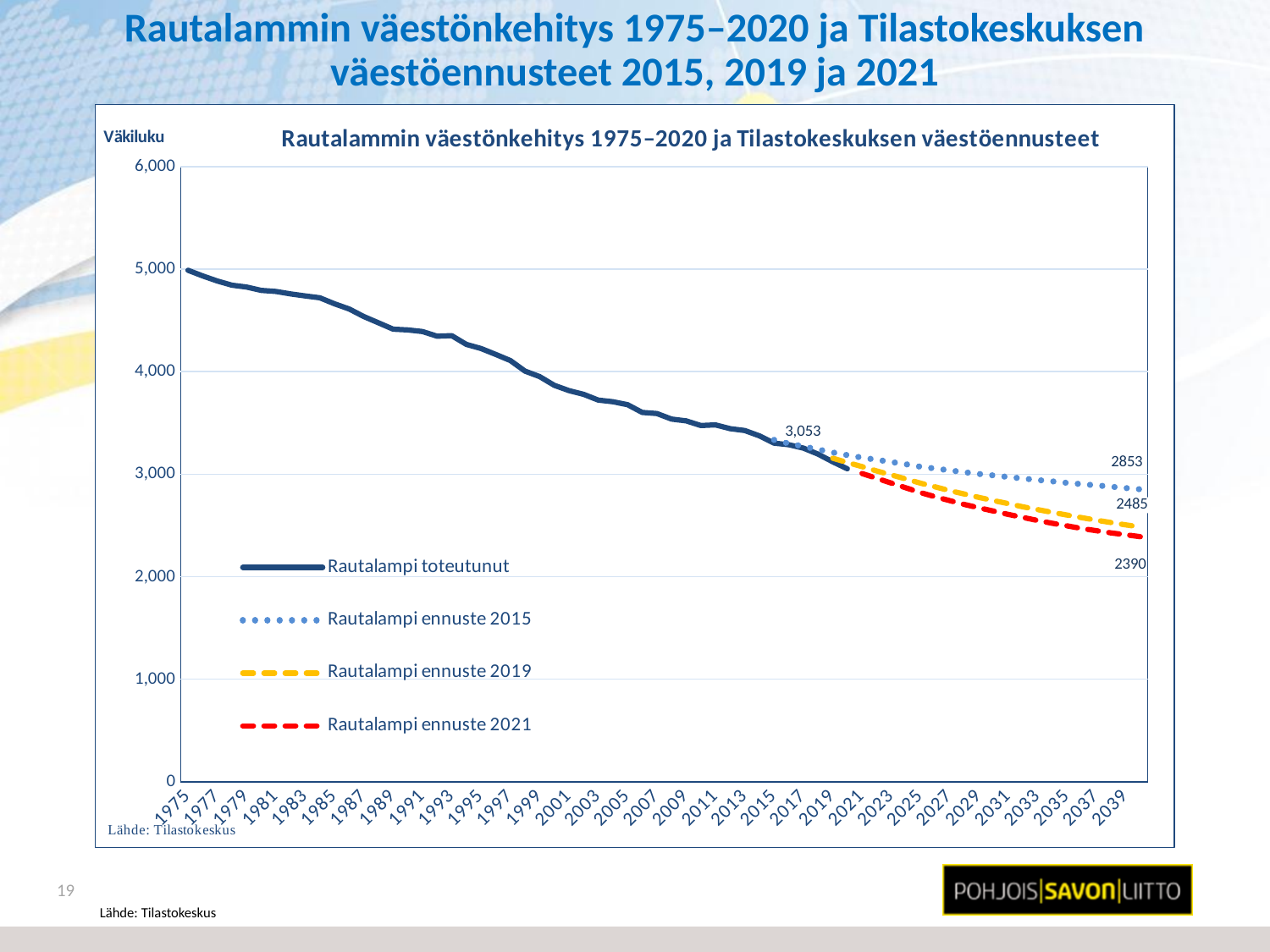
What is the final labelled value of the Rautalampi ennuste 2021 series? 2390 What value is labelled on the Rautalampi toteutunut line? 3,053 What is the final labelled value of the Rautalampi ennuste 2015 series? 2853 What is the final labelled value of the Rautalampi ennuste 2019 series? 2485 Which ends higher, the ennuste 2015 series or the ennuste 2021 series? Rautalampi ennuste 2015 Which forecast series ends at the lowest value? Rautalampi ennuste 2021 Does the Rautalampi toteutunut series rise or fall from 1975 to 2020? fall Is the Rautalampi toteutunut value in 1975 greater or less than 4,000? greater How many series does the legend list? 4 What is the difference between the final values of the ennuste 2015 (2853) and ennuste 2021 (2390) series? 463 What kind of chart is shown on the slide? line chart What is the difference between the final values of the ennuste 2019 (2485) and ennuste 2021 (2390) series? 95